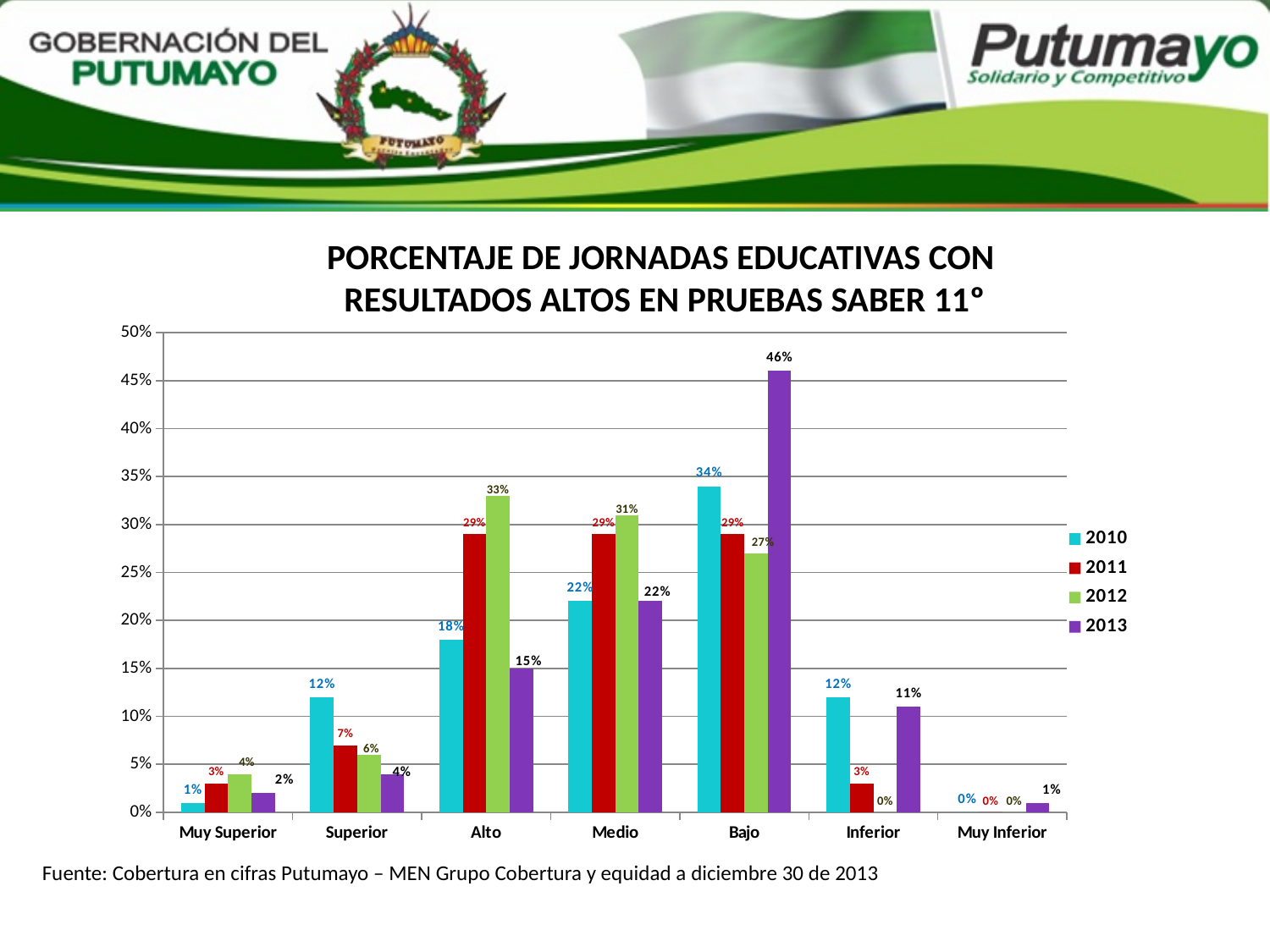
What is the value for 2010 in the Superior category? 12% Which series is shown in purple in the legend? 2013 Which category has the highest value for the 2013 series? Bajo What is the difference between the 2013 and 2010 values in the Bajo category? 12% What is the value for 2012 in the Alto category? 33% What is the value for 2013 in the Bajo category? 46% Which is larger in the Alto category, the 2011 value or the 2013 value? 2011 Is the value for 2012 in the Medio category greater or less than 30%? greater Which category has the lowest value for the 2010 series? Muy Inferior What type of chart is shown on the slide? bar chart How many series does the legend list? 4 How many categories are shown on the x axis? 7